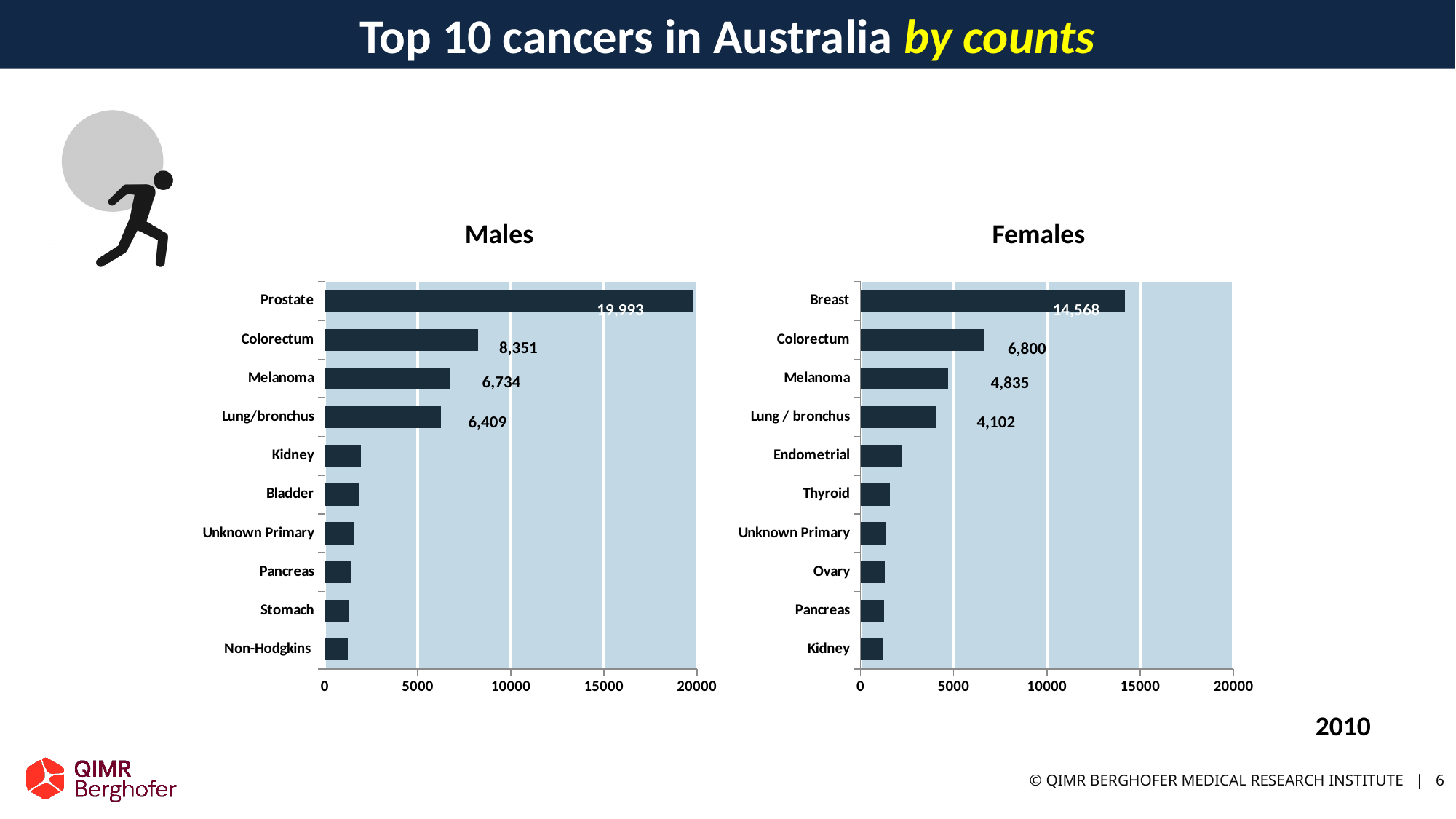
In the Females chart, is the value for Endometrial greater or less than 5000? less What year is shown on the slide for the data? 2010 What type of chart is the Females chart? bar chart How many cancer categories are shown in the Males chart? 10 In the Males chart, which cancer has the highest count? Prostate In the Males chart, what is the count for Melanoma? 6,734 In the Females chart, what is the count for Lung / bronchus? 4,102 In the Males chart, what is the count for Prostate? 19,993 In the Males chart, what is the difference between the Colorectum and Melanoma counts? 1,617 In the Females chart, which cancer has the lowest count? Kidney Which is larger: the Colorectum count in the Males chart or the Colorectum count in the Females chart? Males In the Females chart, what is the count for Breast? 14,568